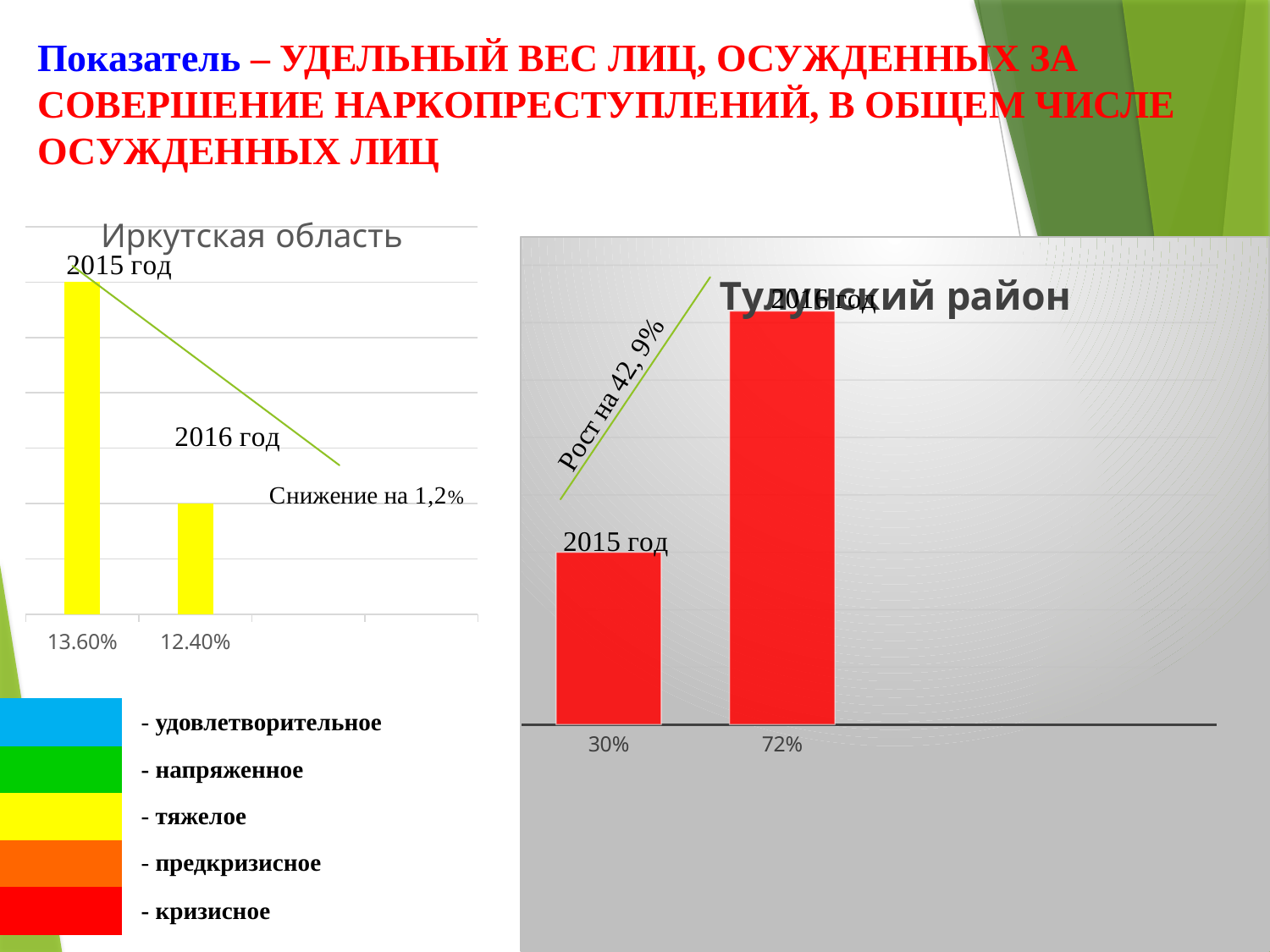
In the chart titled "Иркутская область", do the values rise or fall from 2015 to 2016? fall In the chart titled "Тулунский район", what is the value of the taller bar? 72% In the chart titled "Иркутская область", how many bars are plotted? 2 In the chart titled "Тулунский район", what value is shown for 2015 год? 30% In the chart titled "Тулунский район", what colour are the bars? red What kind of chart is the chart titled "Тулунский район"? bar chart In the chart titled "Иркутская область", what value is shown for 2016 год? 12.40% In the chart titled "Тулунский район", is the bar for 2015 год larger or smaller than the other bar? smaller In the chart titled "Тулунский район", what is the difference between the two bars, 72% and 30%? 42% In the chart titled "Иркутская область", what value is shown for 2015 год? 13.60% In the chart titled "Иркутская область", what change between 2015 and 2016 is stated in the annotation? Снижение на 1,2% In the chart titled "Иркутская область", which year has the higher value? 2015 год